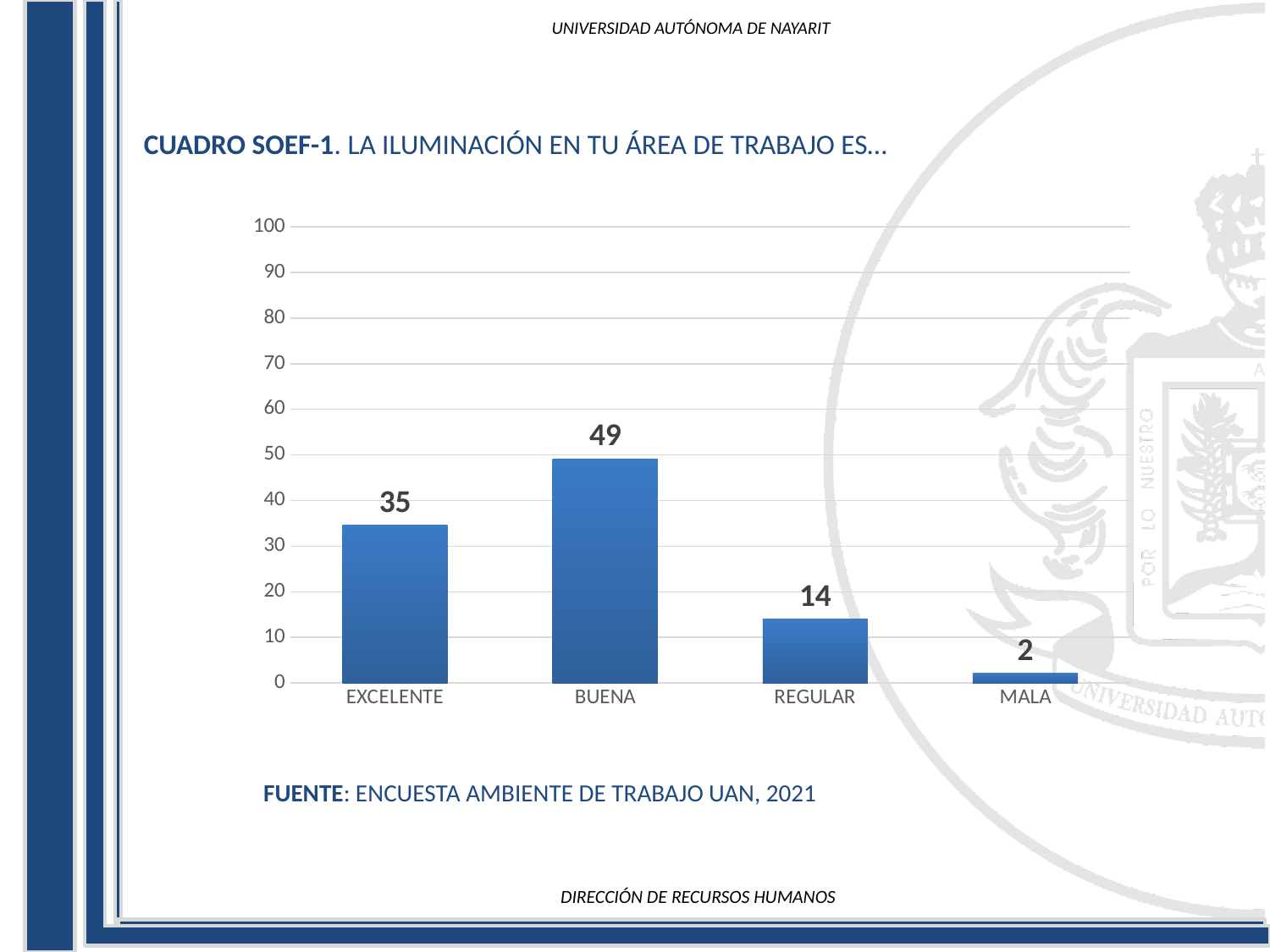
Which category has the lowest value? MALA What is the difference between the values for REGULAR and MALA? 12 Which category has the highest value? BUENA What is the value for MALA? 2 What is the difference between the values for BUENA and EXCELENTE? 14 What kind of chart is shown on the slide? Bar chart What is the value for EXCELENTE? 35 What is the source cited below the chart? ENCUESTA AMBIENTE DE TRABAJO UAN, 2021 What is the value for BUENA? 49 What is the value for REGULAR? 14 How many categories are shown on the x axis? 4 Which is larger, the value for EXCELENTE or the value for REGULAR? EXCELENTE